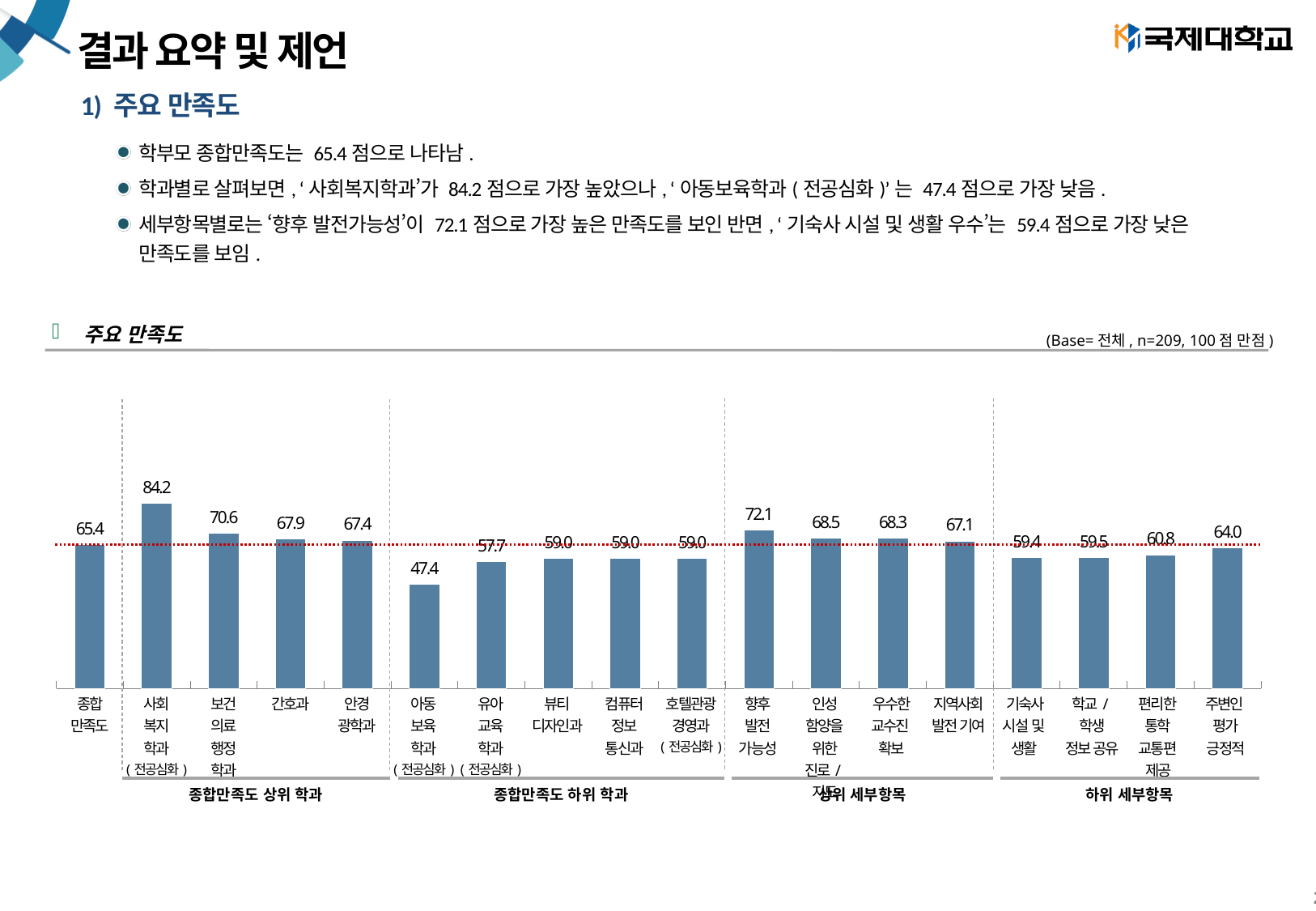
What is the value for 향후 발전가능성 in the chart? 72.1 What is the difference between the values for 사회복지학과 (전공심화) and 아동보육학과 (전공심화)? 36.8 How many bars are plotted in the chart? 18 Which is larger, the value for 보건의료행정학과 or the value for 간호과? 보건의료행정학과 What is the value for 기숙사 시설 및 생활 in the chart? 59.4 Which category has the highest value in the chart? 사회복지학과 (전공심화) What kind of chart is shown on the slide? Bar chart What is the value shown for 종합만족도 in the 주요 만족도 chart? 65.4 What is the difference between the values for 향후 발전가능성 and 기숙사 시설 및 생활? 12.7 What is the value for 사회복지학과 (전공심화) in the chart? 84.2 Which category has the lowest value in the chart? 아동보육학과 (전공심화) What is the sample size stated in the base note above the chart? n=209